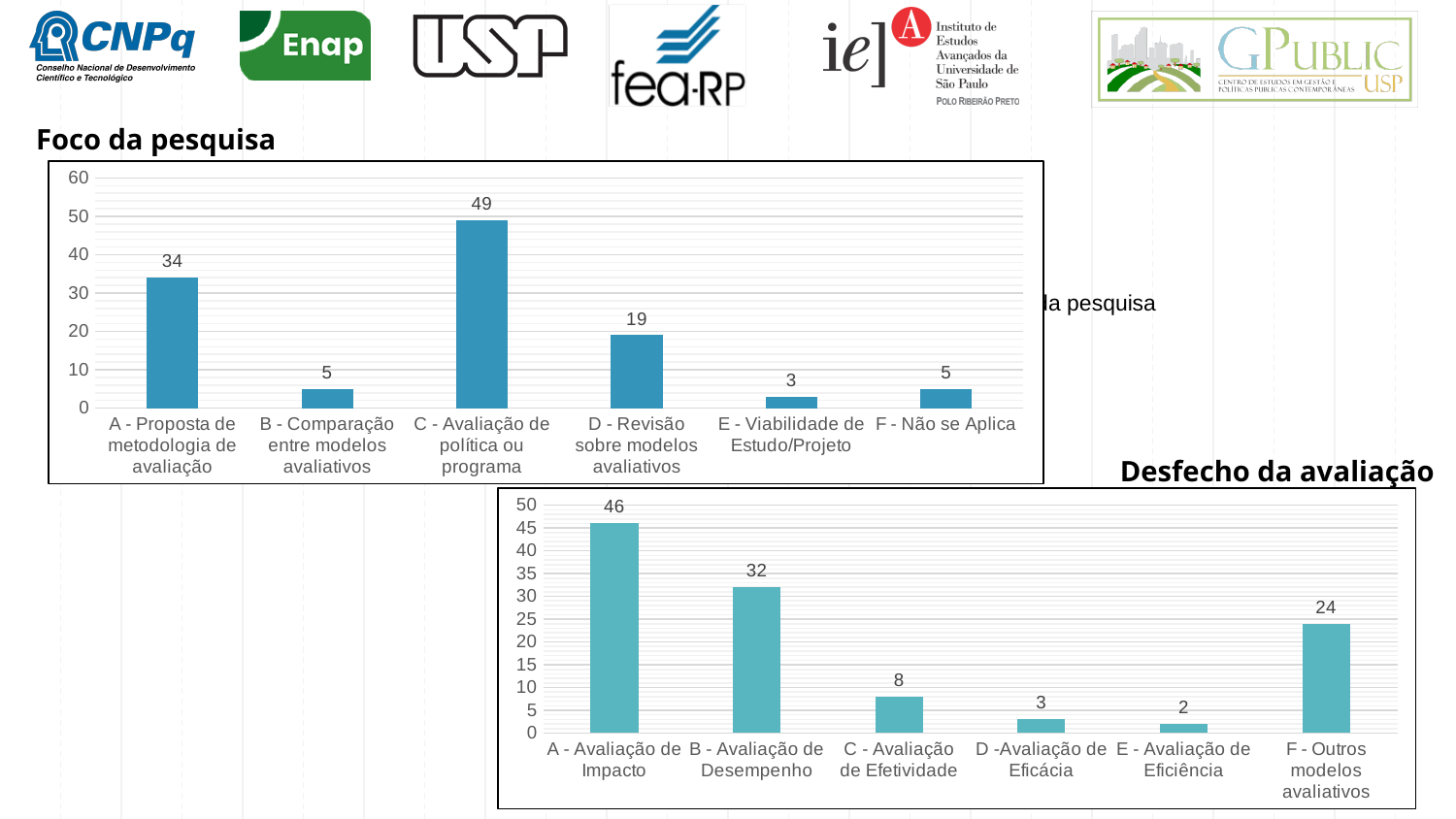
In the 'Foco da pesquisa' chart, what is the value for 'C - Avaliação de política ou programa'? 49 In the 'Desfecho da avaliação' chart, which category has the highest value? A - Avaliação de Impacto In the 'Foco da pesquisa' chart, which category has the lowest value? E - Viabilidade de Estudo/Projeto In the 'Desfecho da avaliação' chart, what is the difference between 'A - Avaliação de Impacto' and 'B - Avaliação de Desempenho'? 14 In the 'Desfecho da avaliação' chart, what is the value for 'B - Avaliação de Desempenho'? 32 In the 'Foco da pesquisa' chart, what is the difference between 'C - Avaliação de política ou programa' and 'A - Proposta de metodologia de avaliação'? 15 In the 'Desfecho da avaliação' chart, what is the value for 'F - Outros modelos avaliativos'? 24 In the 'Foco da pesquisa' chart, what is the value for 'D - Revisão sobre modelos avaliativos'? 19 In the 'Desfecho da avaliação' chart, which category has the lowest value? E - Avaliação de Eficiência What type of chart is the 'Desfecho da avaliação' chart? Bar chart In the 'Desfecho da avaliação' chart, which is larger: 'C - Avaliação de Efetividade' or 'D - Avaliação de Eficácia'? C - Avaliação de Efetividade In the 'Foco da pesquisa' chart, how many categories are shown? 6